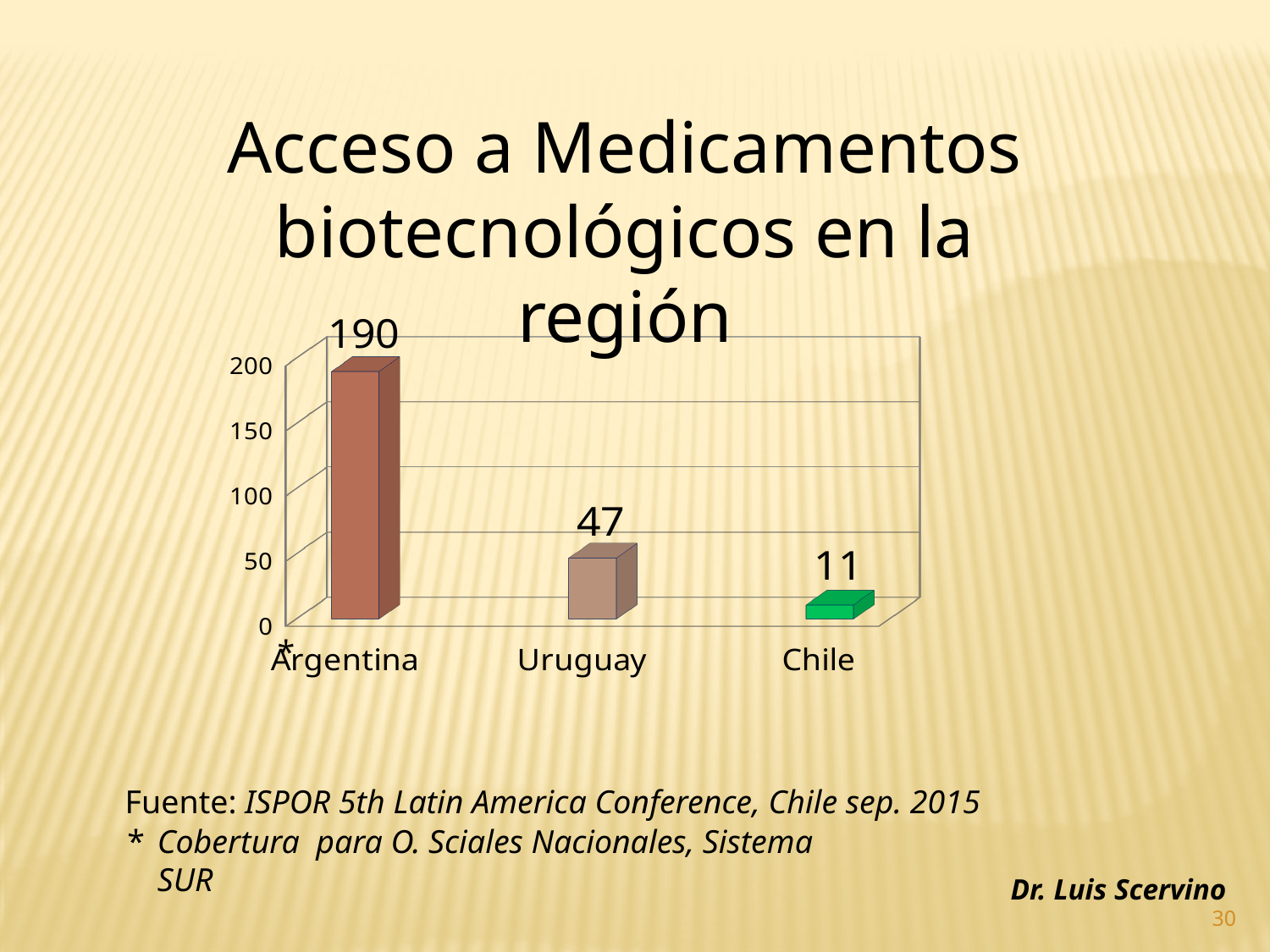
What is the difference between the values for Argentina and Uruguay? 143 What is the value for Uruguay? 47 What is the difference between the values for Uruguay and Chile? 36 How many countries are shown in the chart? 3 Which is larger, the value for Uruguay or the value for Chile? Uruguay Which country has the lowest value? Chile Which country has the highest value? Argentina What is the value for Chile? 11 Do the values rise or fall from Argentina to Chile along the x axis? fall What is the value for Argentina? 190 Is the value for Uruguay greater or less than 50? less What kind of chart is shown on the slide? bar chart